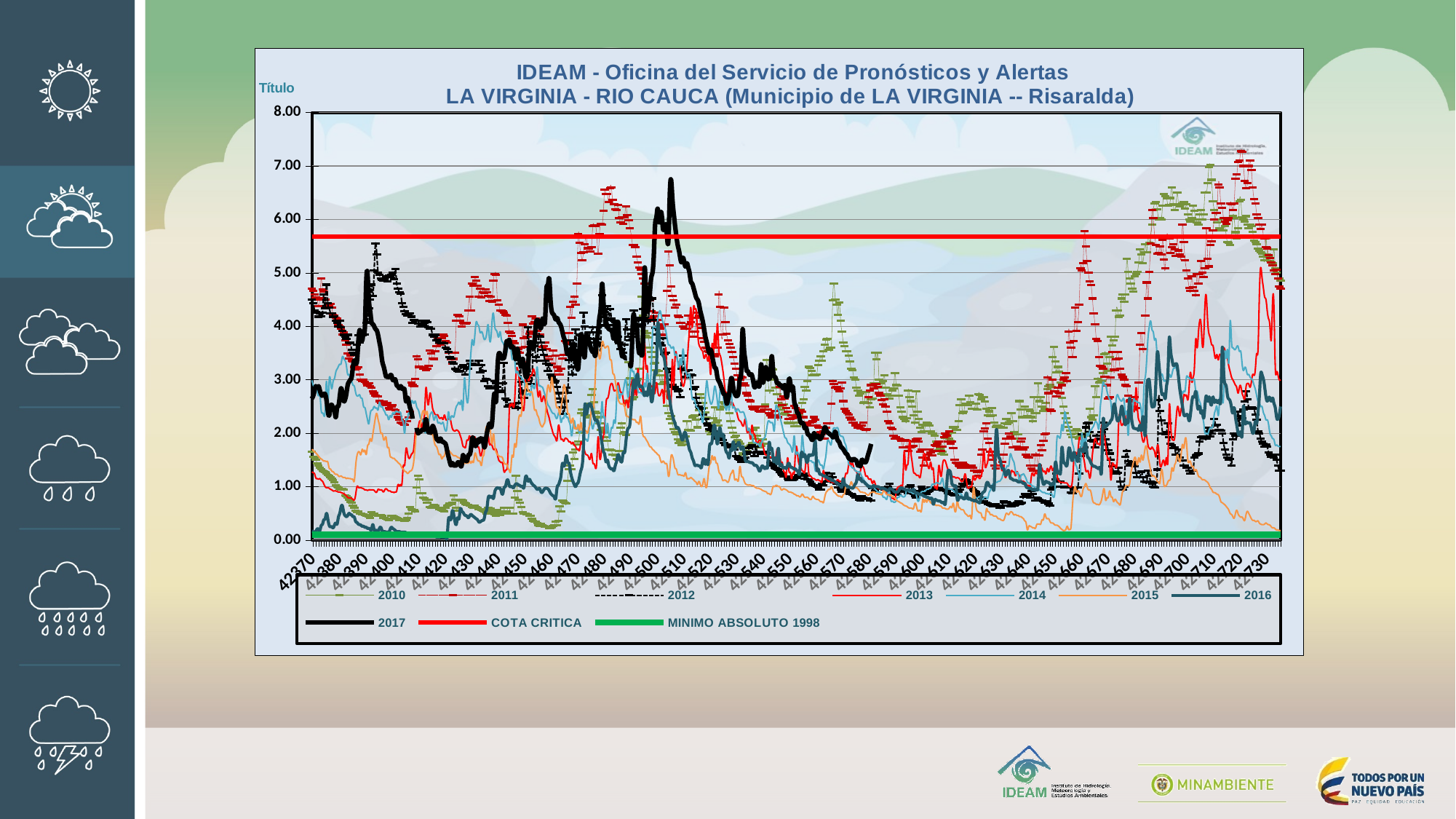
How many series does the chart legend list? 10 Is the value of the COTA CRITICA line greater or less than 6.00? less Does the 2015 series rise or fall between 42660 and 42730? fall Is the peak of the 2011 series near 42720 greater or less than 6.00? greater What is the highest value shown on the y axis? 8.00 What is the second line of the chart title? LA VIRGINIA - RIO CAUCA (Municipio de LA VIRGINIA -- Risaralda) Which legend entry is drawn as a thick red horizontal line across the chart? COTA CRITICA Is the value of the COTA CRITICA line greater or less than 5.00? greater What kind of chart is shown on the slide? line chart